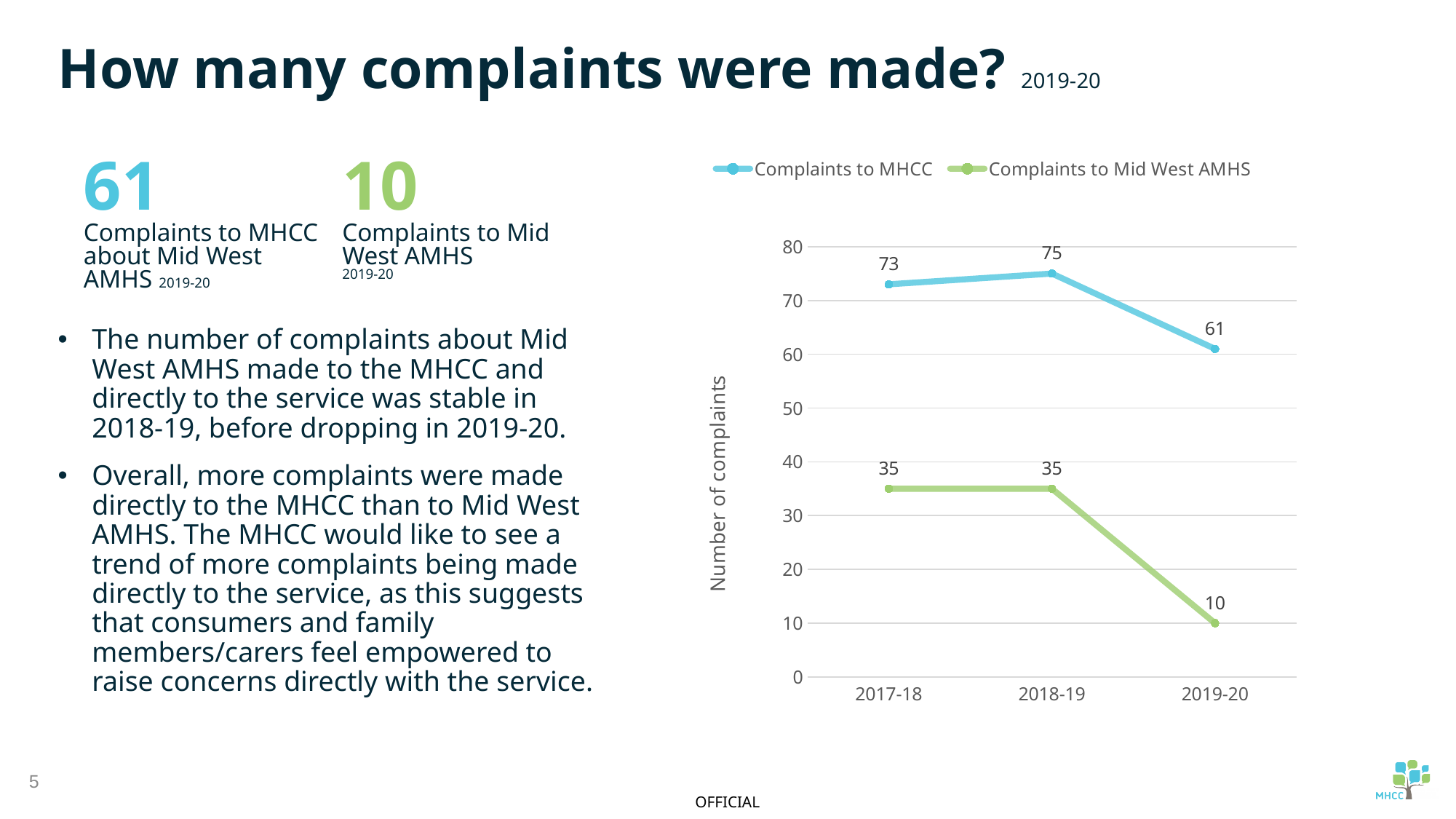
In which year were complaints to MHCC highest? 2018-19 How many series does the chart legend list? 2 What is the label of the y axis of the chart? Number of complaints What is the difference between complaints to MHCC and complaints to Mid West AMHS in 2019-20? 51 By how much did complaints to Mid West AMHS fall from 2018-19 to 2019-20? 25 In which year were complaints to Mid West AMHS lowest? 2019-20 What type of chart is shown on the slide? Line chart How many years are shown on the x axis of the chart? 3 What was the number of complaints to MHCC in 2017-18? 73 What was the number of complaints to Mid West AMHS in 2019-20? 10 What was the number of complaints to MHCC in 2018-19? 75 Which series had more complaints in 2017-18, Complaints to MHCC or Complaints to Mid West AMHS? Complaints to MHCC